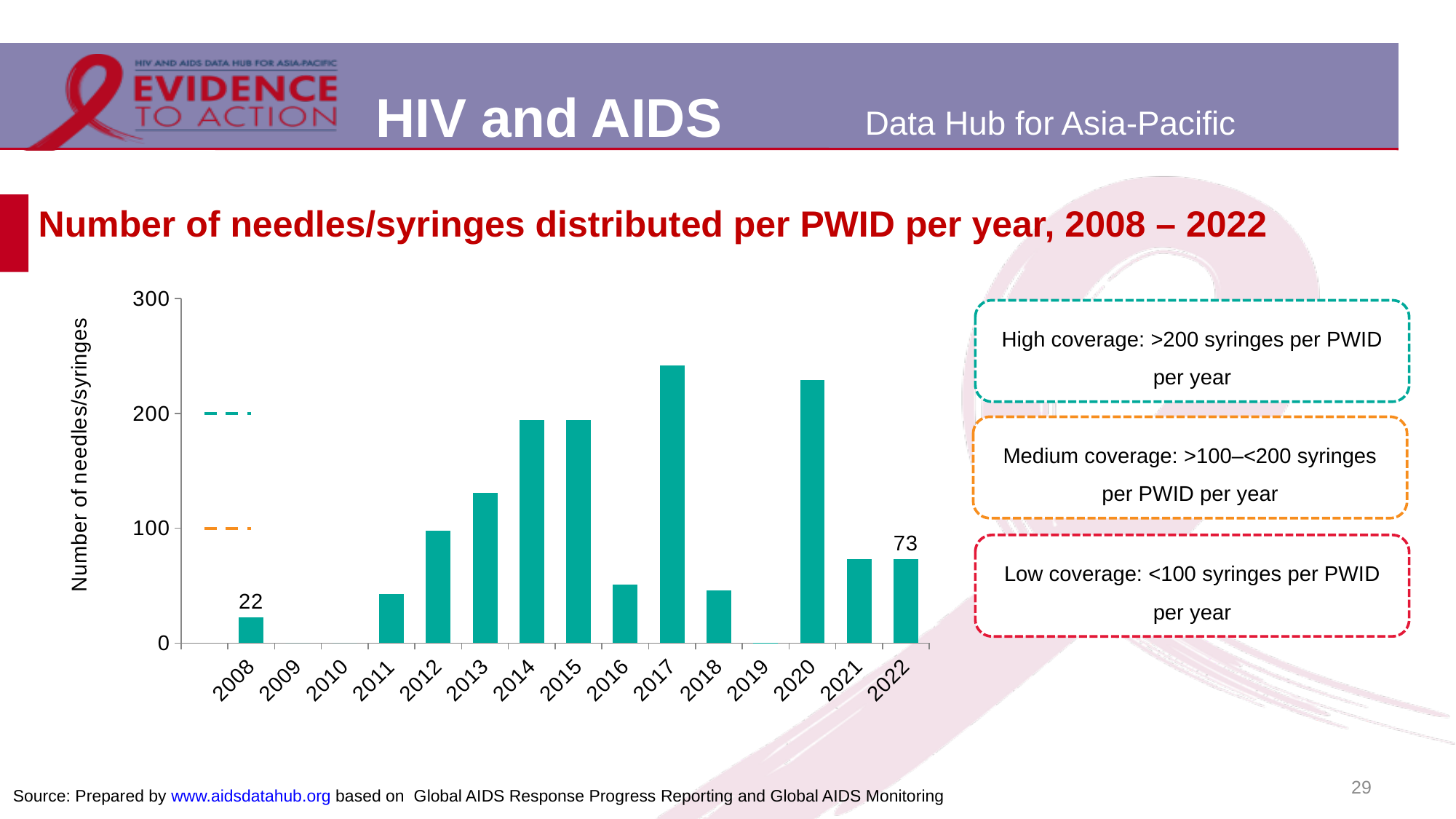
Which year has the higher value, 2008 or 2022? 2022 What is the label of the y axis? Number of needles/syringes Is the value for 2013 greater or less than 100? greater Which year has the highest bar? 2017 What kind of chart is shown on the slide? Bar chart Which year has the higher value, 2016 or 2017? 2017 Is the value for 2017 greater or less than 200? greater What is the difference between the values for 2022 and 2008? 51 Is the value for 2016 greater or less than 100? less What is the value for 2022? 73 How many years are shown on the x axis? 15 What is the value for 2008? 22